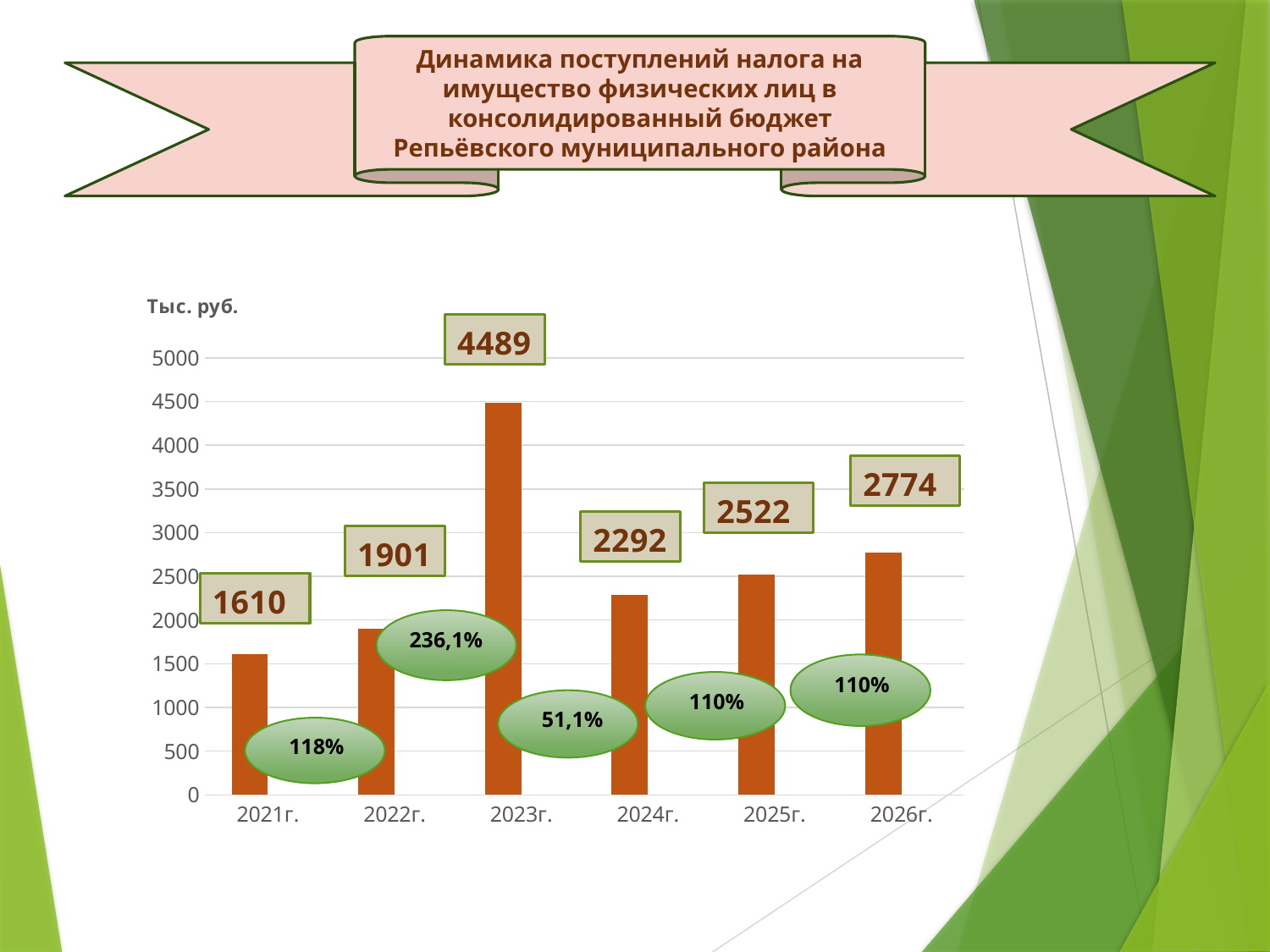
Is the value for 2026г. greater or less than 3000? less How many years are shown on the x axis? 6 What is the difference between the values for 2023г. and 2024г.? 2197 Which year has the lowest value? 2021г. Which year has the highest value? 2023г. What is the value for 2026г.? 2774 What is the value for 2021г.? 1610 Which is larger, the value for 2025г. or the value for 2024г.? 2025г. What unit label is shown above the vertical axis? Тыс. руб. What kind of chart is shown on the slide? bar chart What is the value for 2023г.? 4489 What is the difference between the values for 2022г. and 2021г.? 291